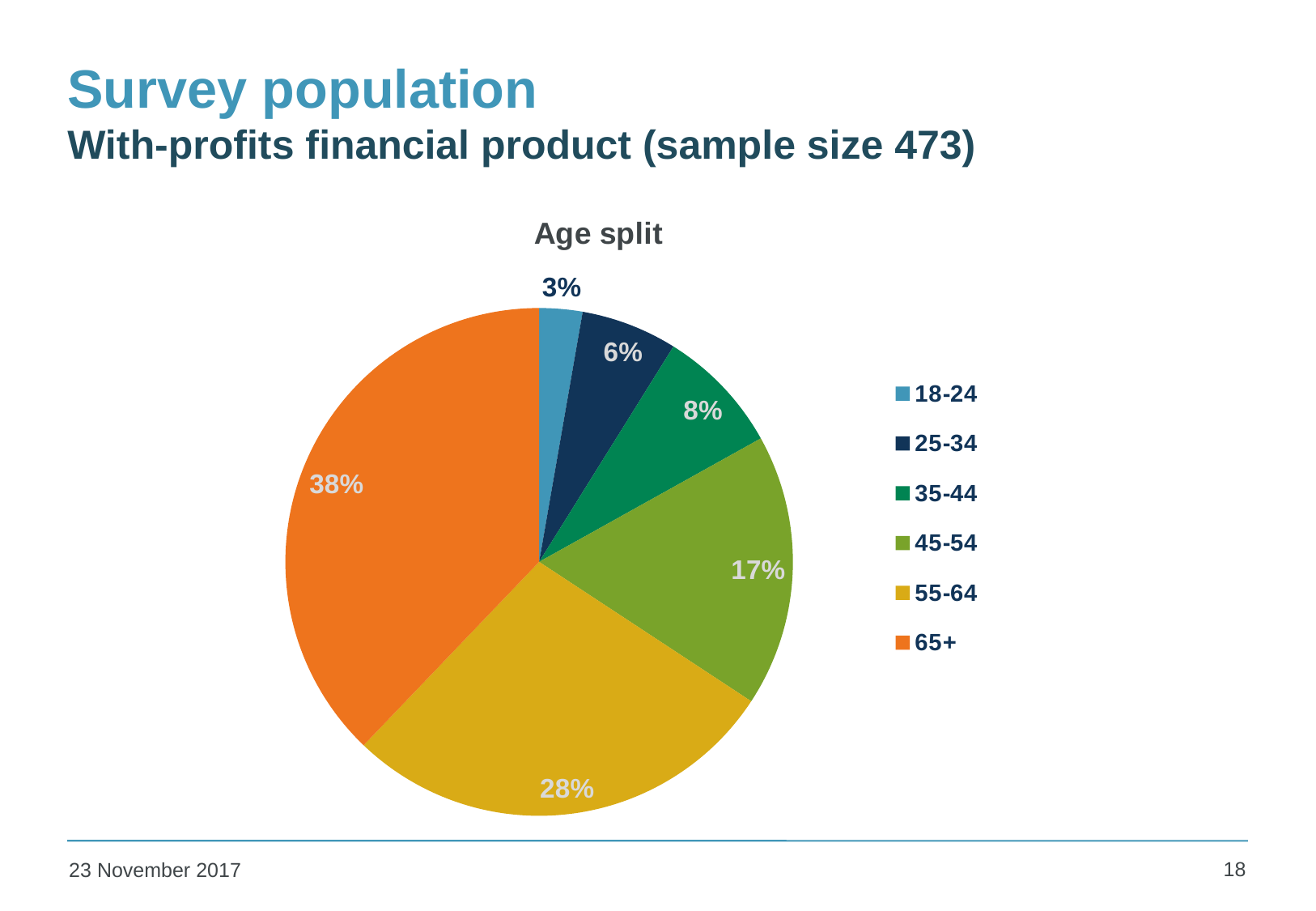
What share of the survey population is aged 35-44? 8% What share of the survey population is aged 55-64? 28% What is the difference in percentage points between the 65+ and 55-64 shares? 10 Which age group has the smallest share of the pie? 18-24 What is the combined share of the 45-54 and 55-64 age groups? 45% What share of the survey population is aged 18-24? 3% What kind of chart is shown on the slide? pie chart What share of the survey population is aged 65+? 38% Which age group has the largest share of the pie? 65+ What is the title of the chart? Age split Which age group has a larger share, 25-34 or 45-54? 45-54 How many age groups are shown in the pie chart? 6